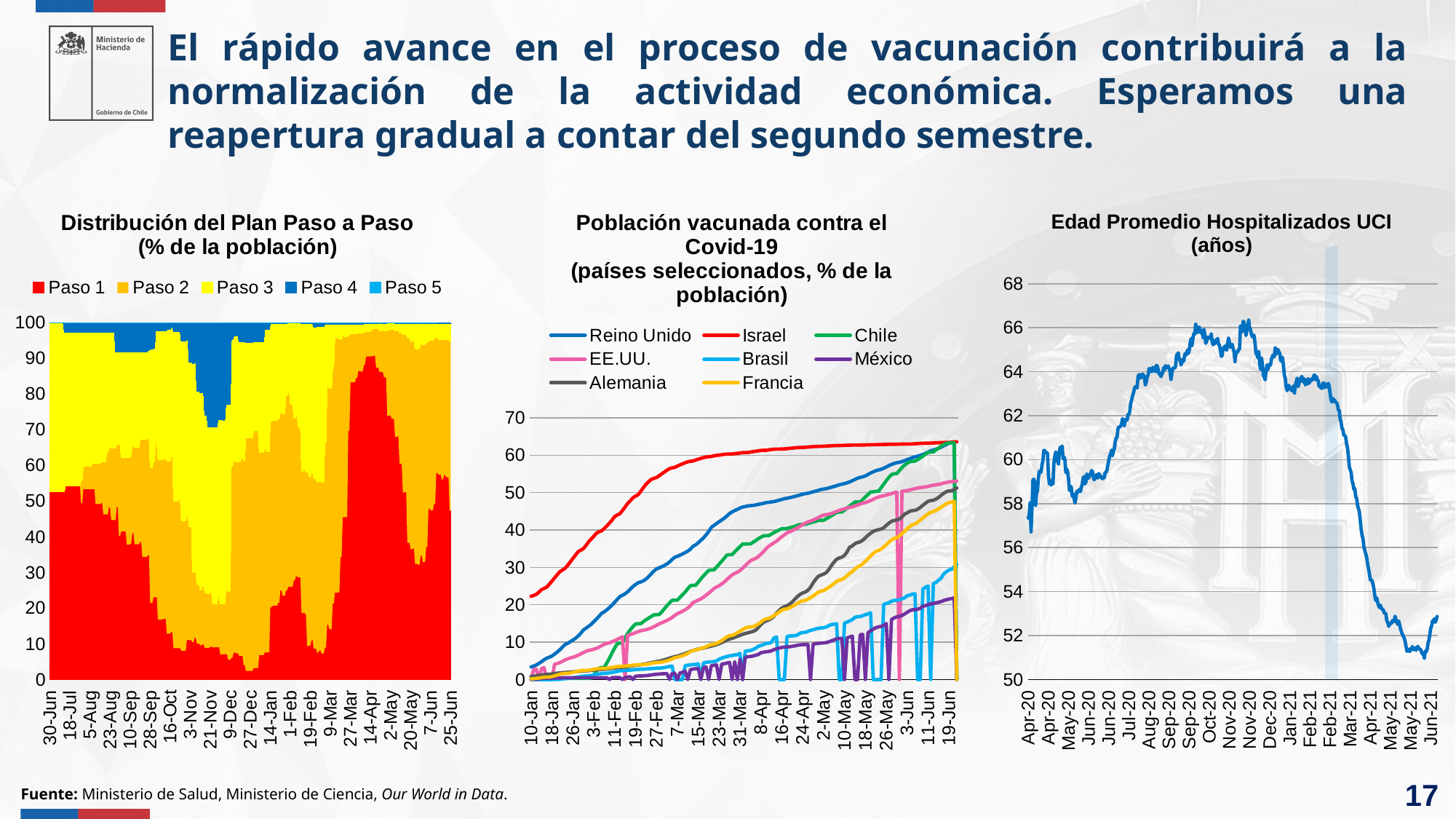
What kind of chart is 'Edad Promedio Hospitalizados UCI'? line chart In the chart 'Población vacunada contra el Covid-19', is the value for Israel at 19-Jun greater or less than 60? greater In the chart 'Distribución del Plan Paso a Paso', how many series does the legend list? 5 In the chart 'Población vacunada contra el Covid-19', is the value for México at 19-Jun greater or less than 30? less In the chart 'Distribución del Plan Paso a Paso', is the value for Paso 1 around 14-Apr greater or less than 80? greater How many charts are shown on the slide? 3 In the chart 'Población vacunada contra el Covid-19', which country has the highest vaccinated share in March 2021? Israel What kind of chart is 'Población vacunada contra el Covid-19'? line chart In the chart 'Edad Promedio Hospitalizados UCI', do the values rise or fall between Feb-21 and Jun-21? fall In the chart 'Población vacunada contra el Covid-19', how many series does the legend list? 8